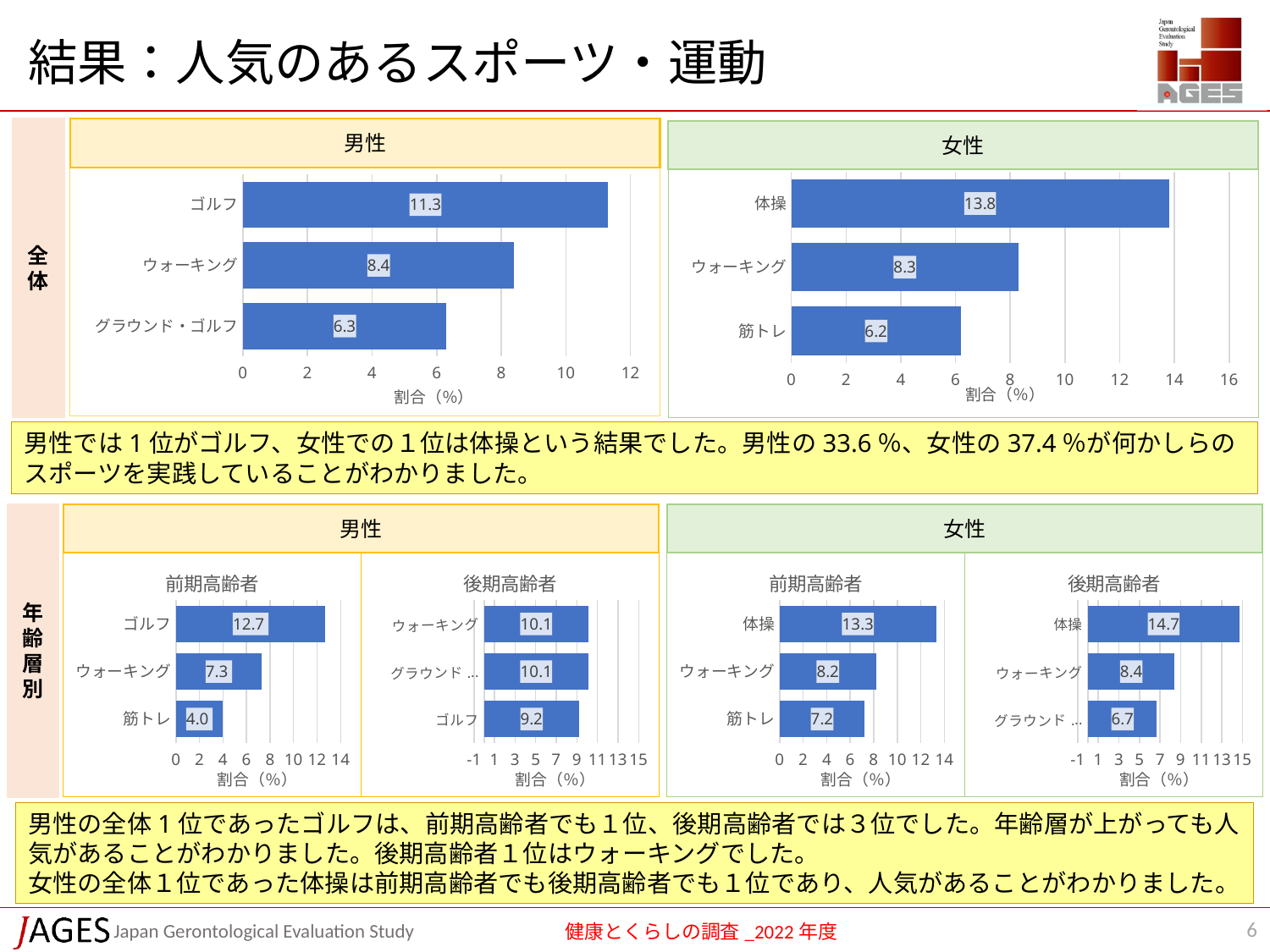
In the top-left chart (全体, 男性), which category has the lowest value? グラウンド・ゴルフ In the bottom chart for 女性 前期高齢者, what is the value for 筋トレ? 7.2 In the top-left chart (全体, 男性), what is the value for ゴルフ? 11.3 In the top-right chart (全体, 女性), what is the value for 体操? 13.8 In the bottom chart for 男性 前期高齢者, what is the value for 筋トレ? 4.0 In the top-left chart (全体, 男性), what is the difference between ゴルフ and ウォーキング? 2.9 In the bottom chart for 女性 後期高齢者, which category has the highest value? 体操 How many categories are shown in the top-left chart (全体, 男性)? 3 In the bottom chart for 男性 後期高齢者, what is the value for ゴルフ? 9.2 What type of chart is the top-right chart (全体, 女性)? Bar chart In the top-right chart (全体, 女性), what is the difference between 体操 and 筋トレ? 7.6 Which is larger: ウォーキング in the top-left chart (全体, 男性) or ウォーキング in the top-right chart (全体, 女性)? 男性 (8.4)